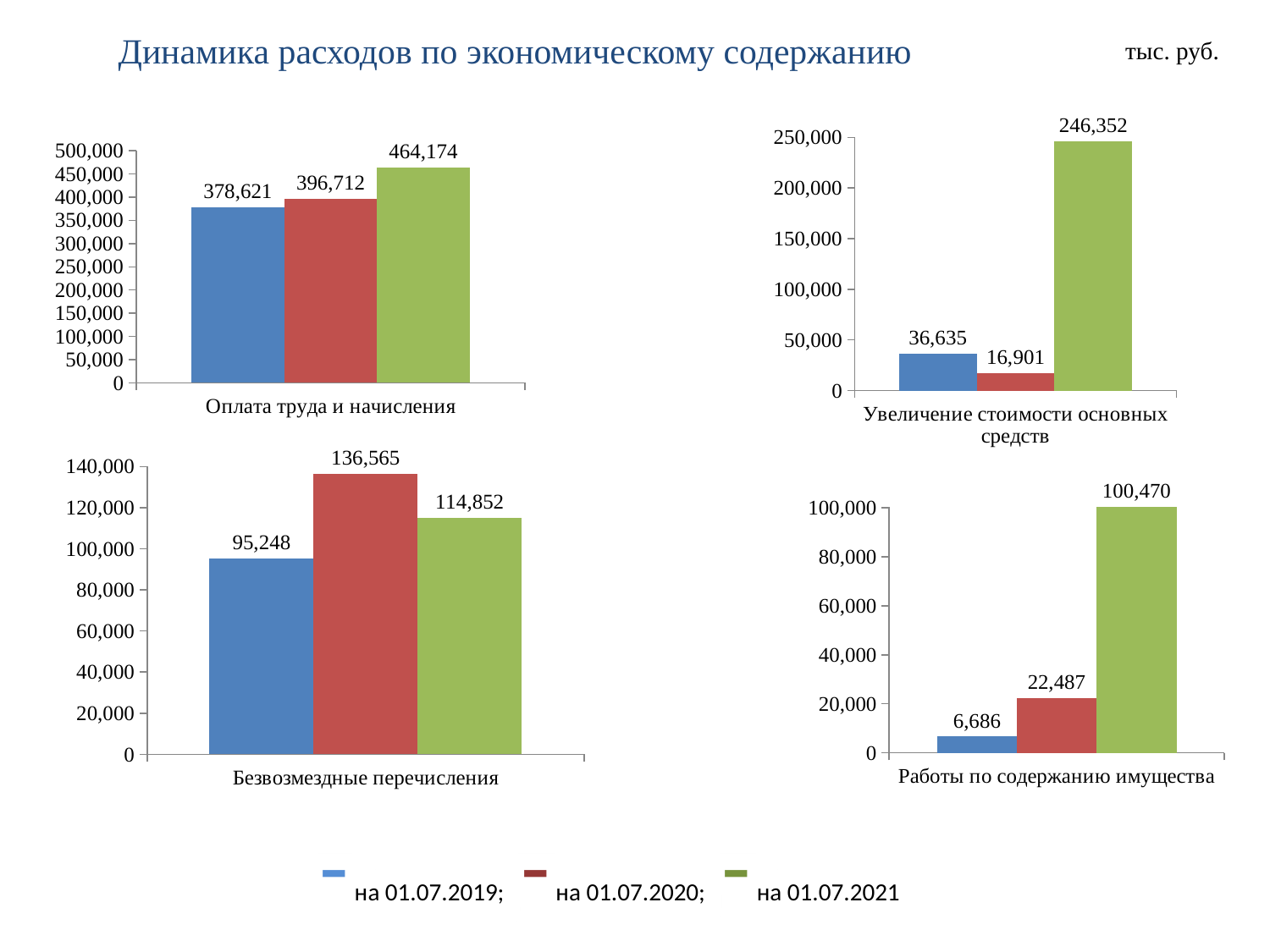
In the chart 'Безвозмездные перечисления', which is larger: the value for на 01.07.2021 or на 01.07.2019? на 01.07.2021 In the chart 'Оплата труда и начисления', what is the value for на 01.07.2021? 464,174 What kind of chart is 'Оплата труда и начисления'? bar chart How many series does the legend at the bottom of the slide list? 3 In the chart 'Безвозмездные перечисления', what is the value for на 01.07.2019? 95,248 In the chart 'Работы по содержанию имущества', what is the value for на 01.07.2020? 22,487 In the chart 'Работы по содержанию имущества', what is the difference between the values for на 01.07.2021 and на 01.07.2019? 93,784 In the chart 'Оплата труда и начисления', what is the difference between the values for на 01.07.2021 and на 01.07.2019? 85,553 In the chart 'Увеличение стоимости основных средств', which series has the lowest value? на 01.07.2020 In the chart 'Увеличение стоимости основных средств', what is the value for на 01.07.2020? 16,901 In the chart 'Безвозмездные перечисления', which series has the highest value? на 01.07.2020 In the chart 'Оплата труда и начисления', do the values rise or fall from на 01.07.2019 to на 01.07.2021? rise